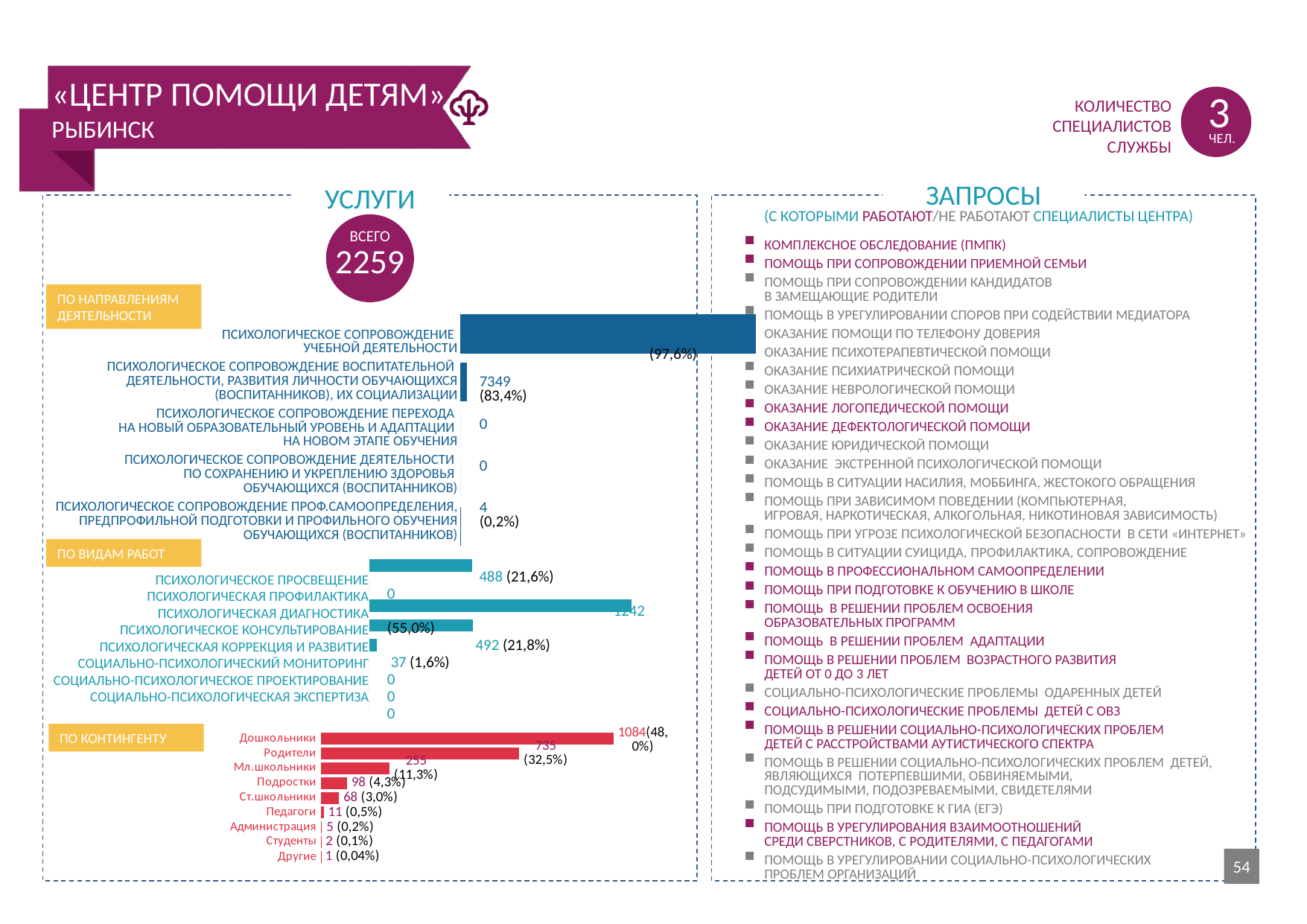
In the 'ПО ВИДАМ РАБОТ' chart, which category has the highest value? Психологическая диагностика How many categories are shown in the 'ПО КОНТИНГЕНТУ' chart? 9 In the 'ПО КОНТИНГЕНТУ' chart, which category has the highest value? Дошкольники In the 'ПО КОНТИНГЕНТУ' chart, which is larger: Мл.школьники or Ст.школьники? Мл.школьники In the 'ПО КОНТИНГЕНТУ' chart, what is the value for Педагоги? 11 (0,5%) In the 'ПО КОНТИНГЕНТУ' chart, what is the value for Родители? 735 (32,5%) In the 'ПО НАПРАВЛЕНИЯМ ДЕЯТЕЛЬНОСТИ' chart, which category has the longest bar? Психологическое сопровождение учебной деятельности In the 'ПО КОНТИНГЕНТУ' chart, what is the value for Подростки? 98 (4,3%) In the 'ПО КОНТИНГЕНТУ' chart, what is the difference between Дошкольники and Родители? 349 What total number of services (ВСЕГО) is shown in the 'УСЛУГИ' section? 2259 In the 'ПО КОНТИНГЕНТУ' chart, which category has the lowest value? Другие What type of chart is the 'ПО КОНТИНГЕНТУ' chart? bar chart